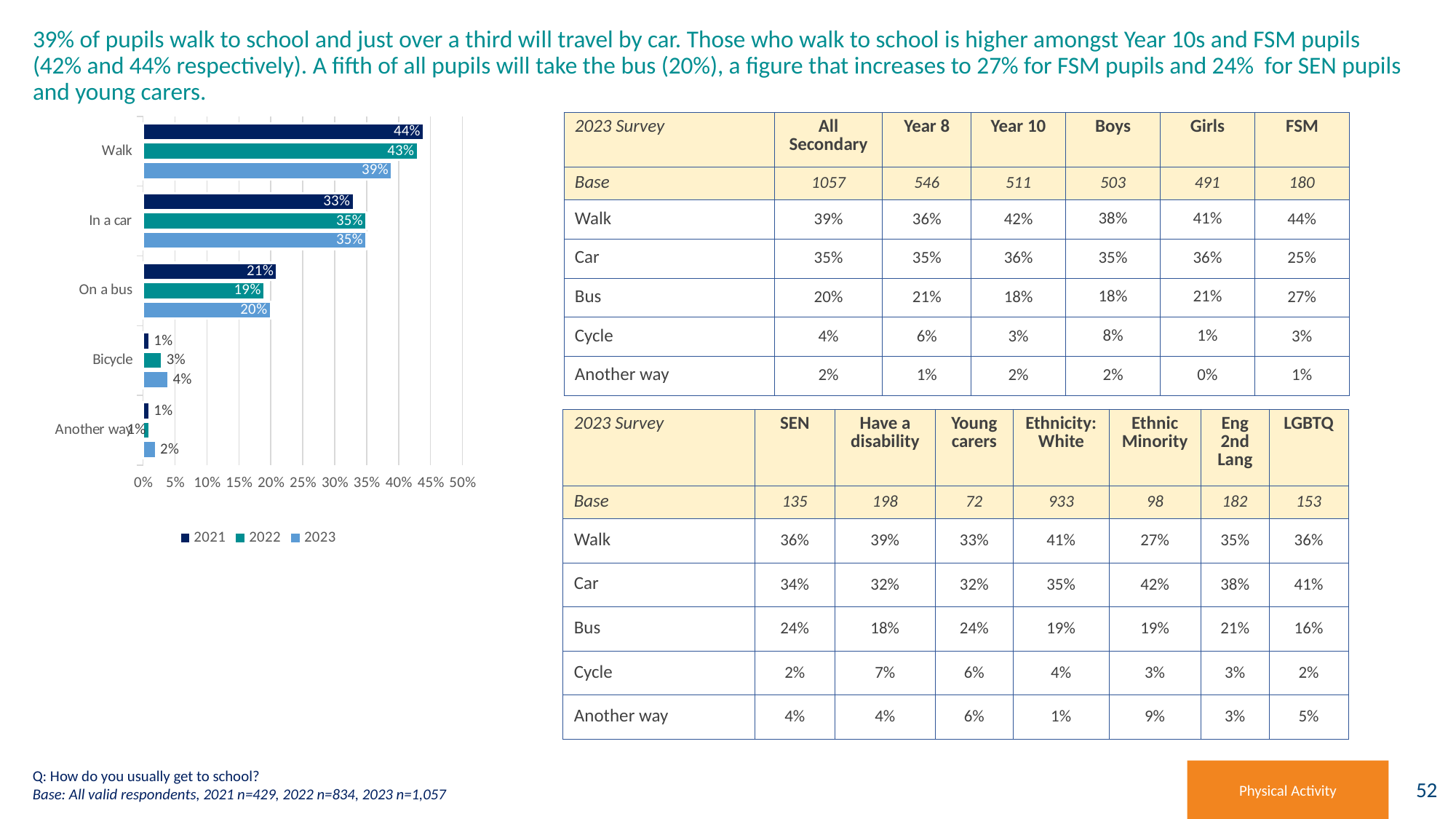
What is the 2023 value for Bicycle in the chart? 4% What is the 2022 value for On a bus in the chart? 19% Which is larger in the chart: the 2021 value for On a bus or the 2022 value for On a bus? 2021 What is the 2023 value for Walk in the chart? 39% Which category has the highest 2021 value in the chart? Walk What kind of chart is shown on the slide? bar chart What is the 2021 value for In a car in the chart? 33% How many categories are shown on the chart? 5 Which category has the lowest 2023 value in the chart? Another way Which series is shown in the darkest blue colour in the chart? 2021 What is the difference between the 2021 and 2023 values for Walk in the chart? 5% How many series does the chart's legend list? 3